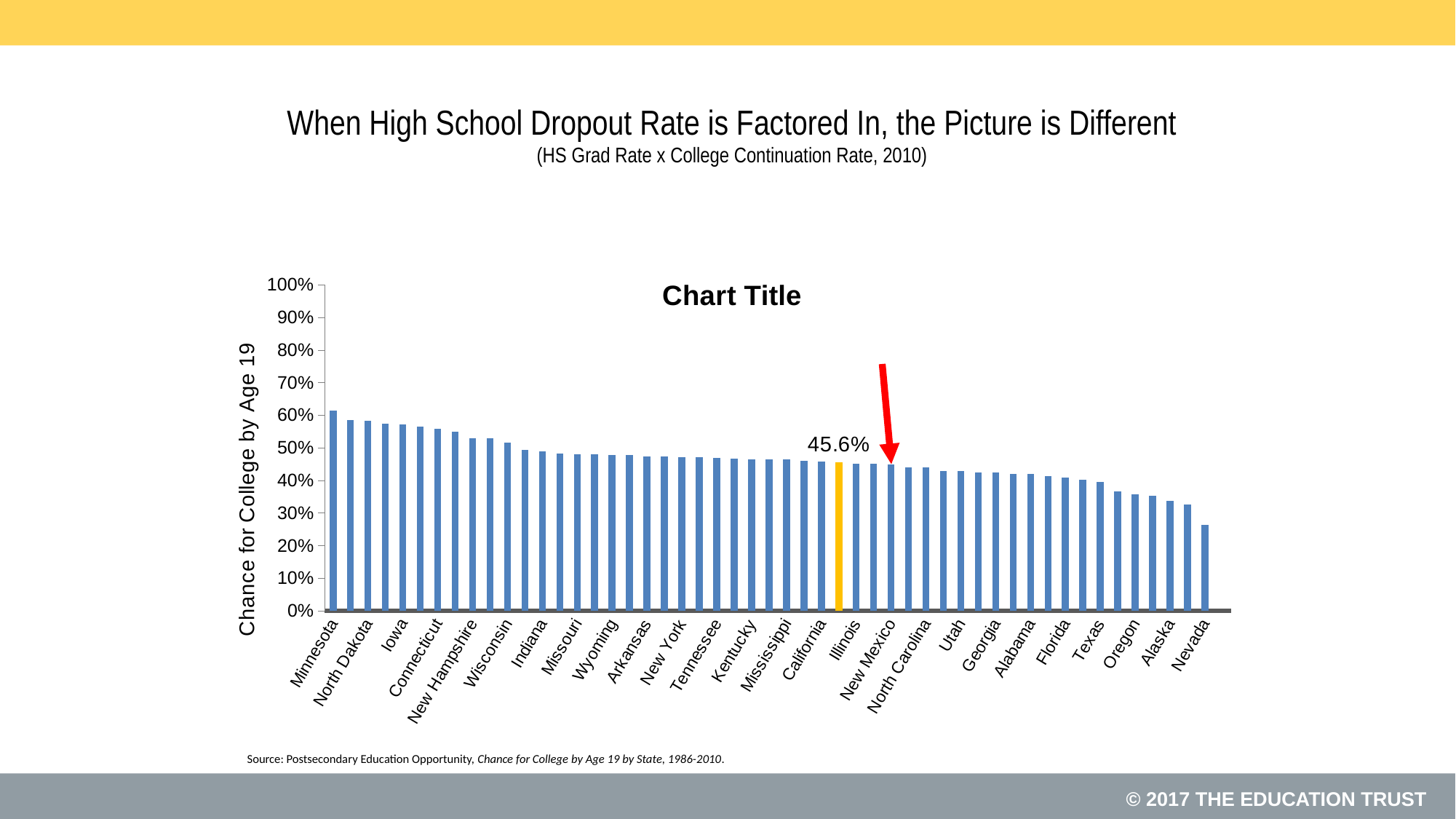
Which has the larger value, Iowa or Texas? Iowa Is the value for Alaska greater or less than 40%? less What colour is the single highlighted bar that differs from the others? yellow Do the values rise or fall moving from left to right along the x axis? fall What kind of chart is shown on the slide? bar chart Is the value for Nevada greater or less than 30%? less Which state has the highest chance for college by age 19? Minnesota What value is printed on the highlighted yellow bar? 45.6% Is the value for Minnesota greater or less than 50%? greater What is the label on the vertical axis? Chance for College by Age 19 Which state has the lowest chance for college by age 19? Nevada